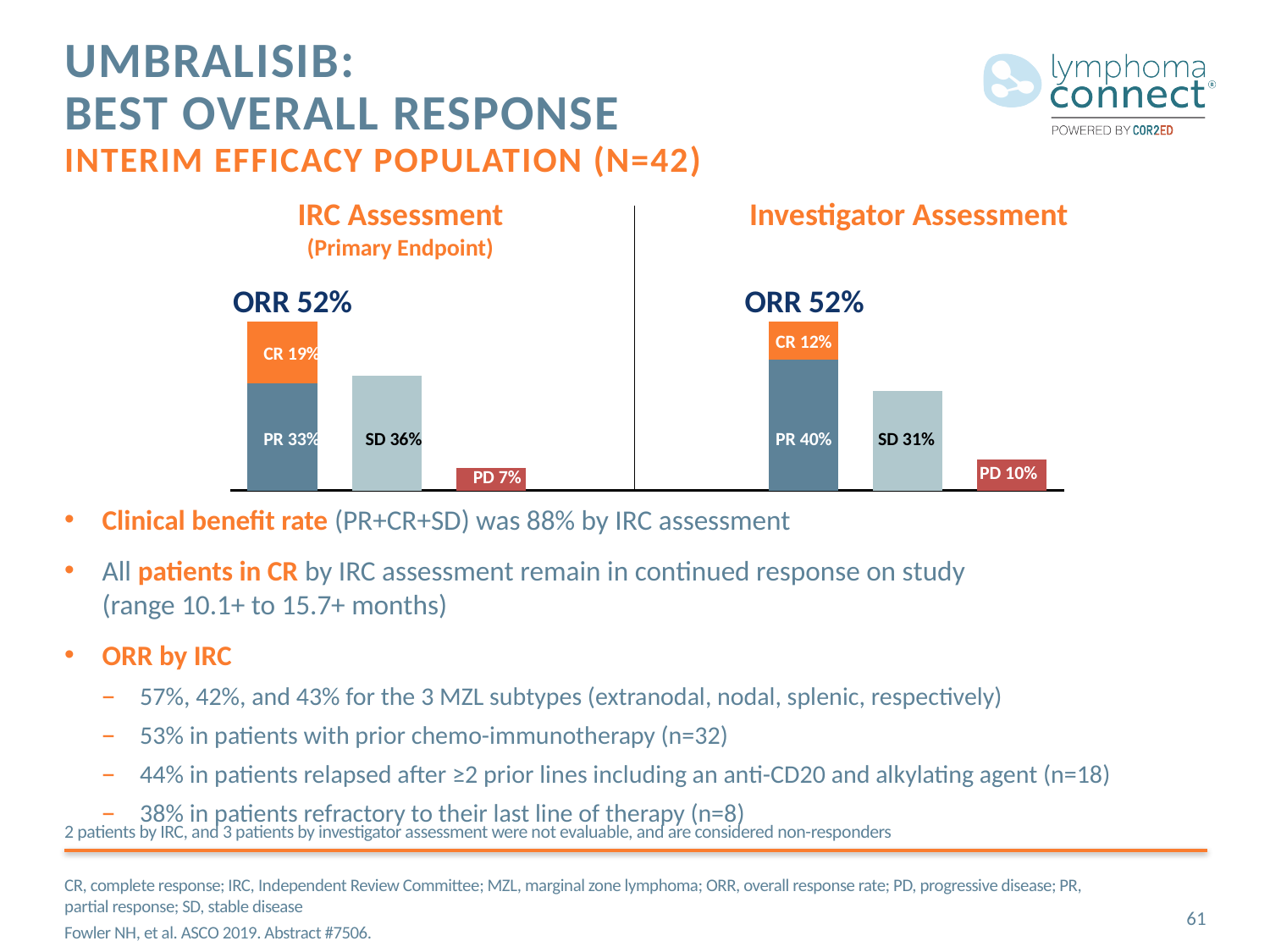
Which is larger: SD in the IRC Assessment chart or SD in the Investigator Assessment chart? SD in the IRC Assessment chart In the IRC Assessment chart, what is the ORR shown above the stacked bar? 52% What is the difference between the PR values in the Investigator Assessment chart and the IRC Assessment chart? 7% In the IRC Assessment chart, what is the value for SD? 36% In the Investigator Assessment chart, what is the value for PD? 10% In the Investigator Assessment chart, what is the value for PR? 40% What kind of chart is used for the IRC Assessment? Stacked bar chart In the IRC Assessment chart, which response category has the lowest value? PD In the IRC Assessment chart, what is the value for CR? 19% What subtitle appears under the IRC Assessment chart title? (Primary Endpoint) In the Investigator Assessment chart, which single response category has the highest value? PR In the Investigator Assessment chart, what is the total of the stacked CR and PR bar? 52%